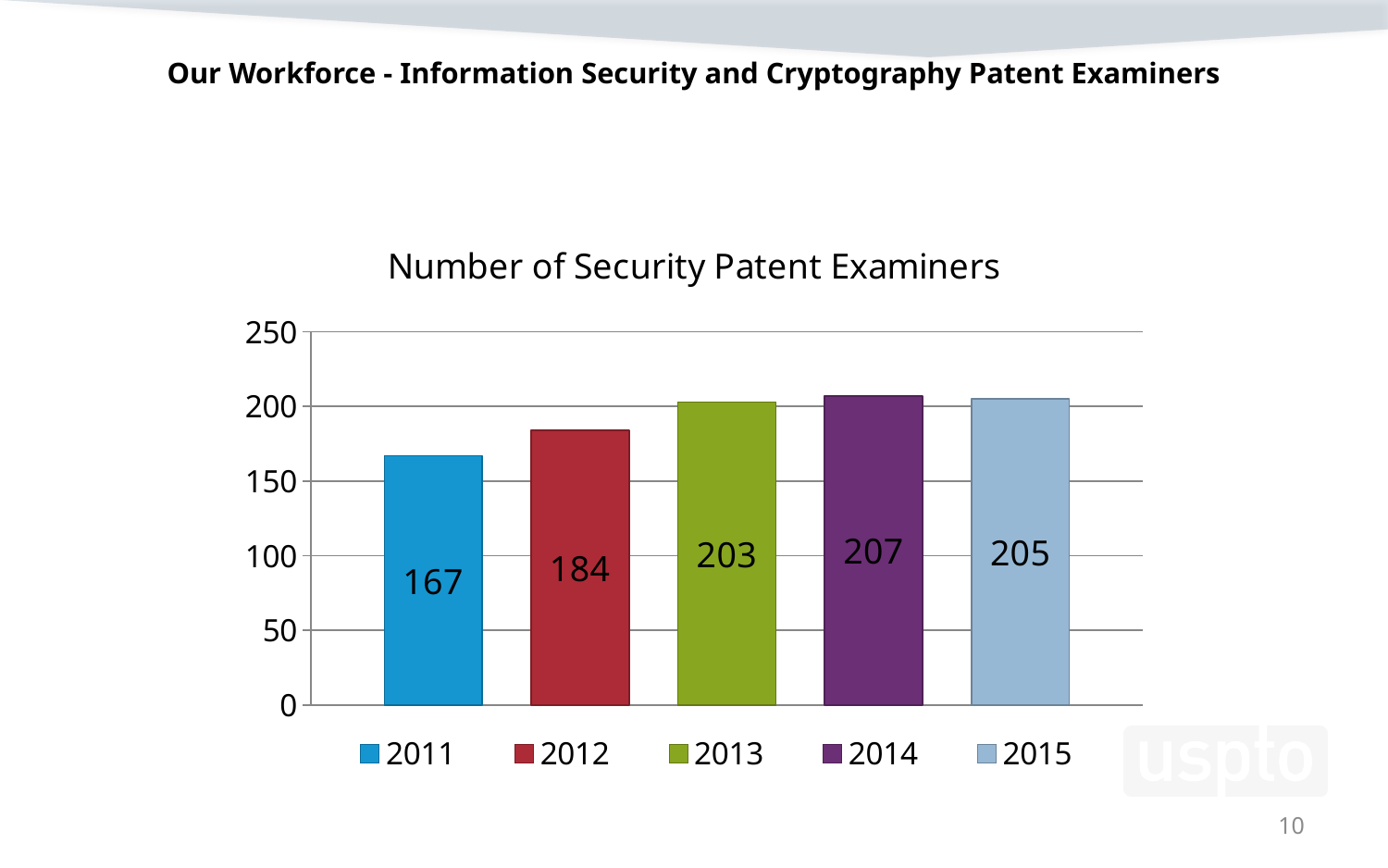
Is the number of security patent examiners in 2012 greater or less than 200? less Which year has the lowest number of security patent examiners? 2011 What is the number of security patent examiners in 2011? 167 How many years are shown in the chart? 5 Which year has more security patent examiners, 2012 or 2013? 2013 What is the number of security patent examiners in 2014? 207 What is the title of the chart? Number of Security Patent Examiners What is the difference in the number of security patent examiners between 2015 and 2011? 38 What is the number of security patent examiners in 2015? 205 What type of chart is shown on the slide? bar chart What is the difference in the number of security patent examiners between 2013 and 2012? 19 Which year has the highest number of security patent examiners? 2014